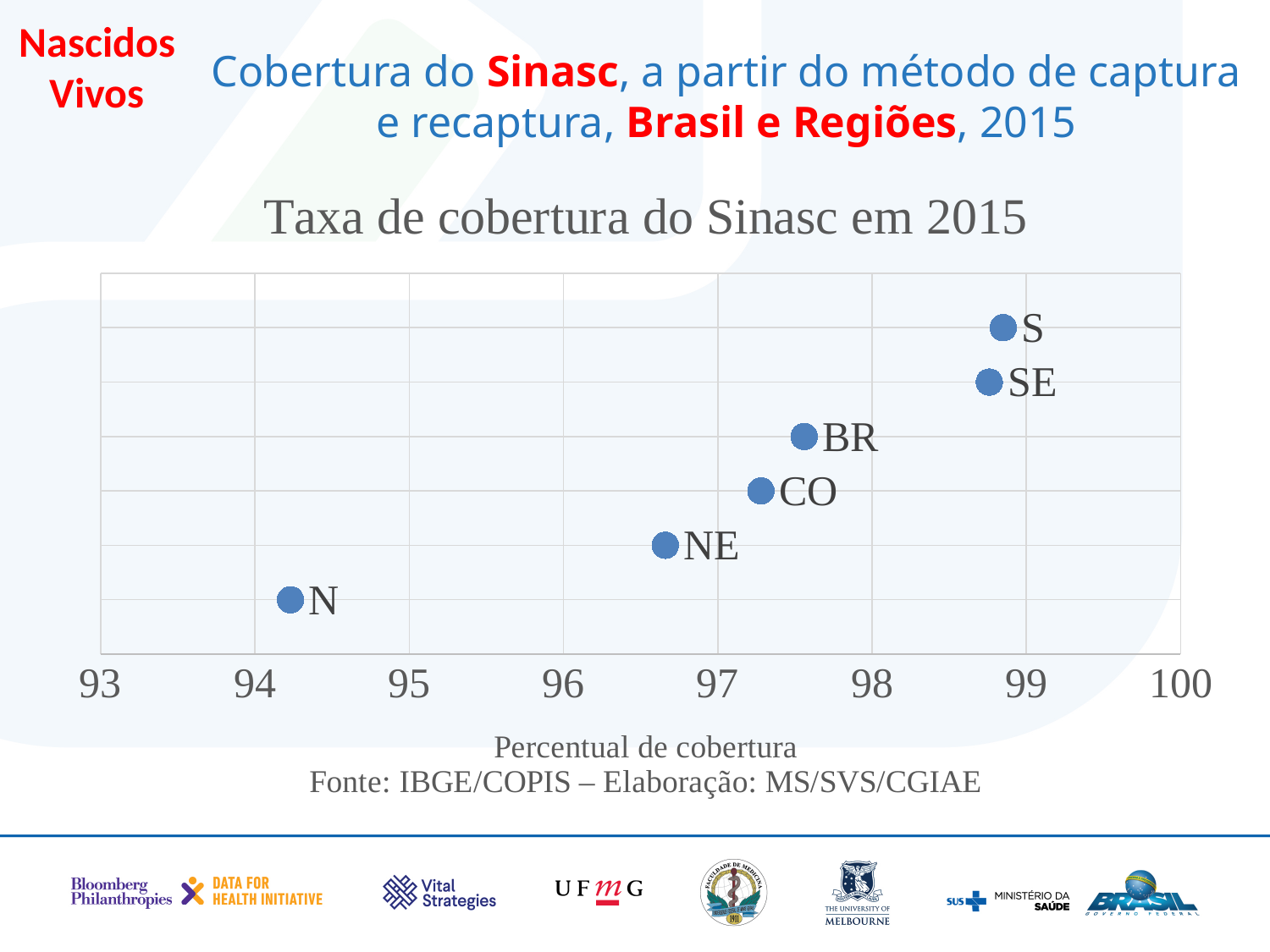
Which has a higher coverage percentage, N or NE? NE Which region has the lowest coverage percentage in the chart? N Is the value for NE greater or less than 97? less Is the value for NE greater or less than 96? greater What kind of chart is shown on the slide? Scatter chart What is the label of the x axis of the chart? Percentual de cobertura Is the value for SE greater or less than 98? greater How many data points are plotted in the chart? 6 Which has a higher coverage percentage, CO or SE? SE